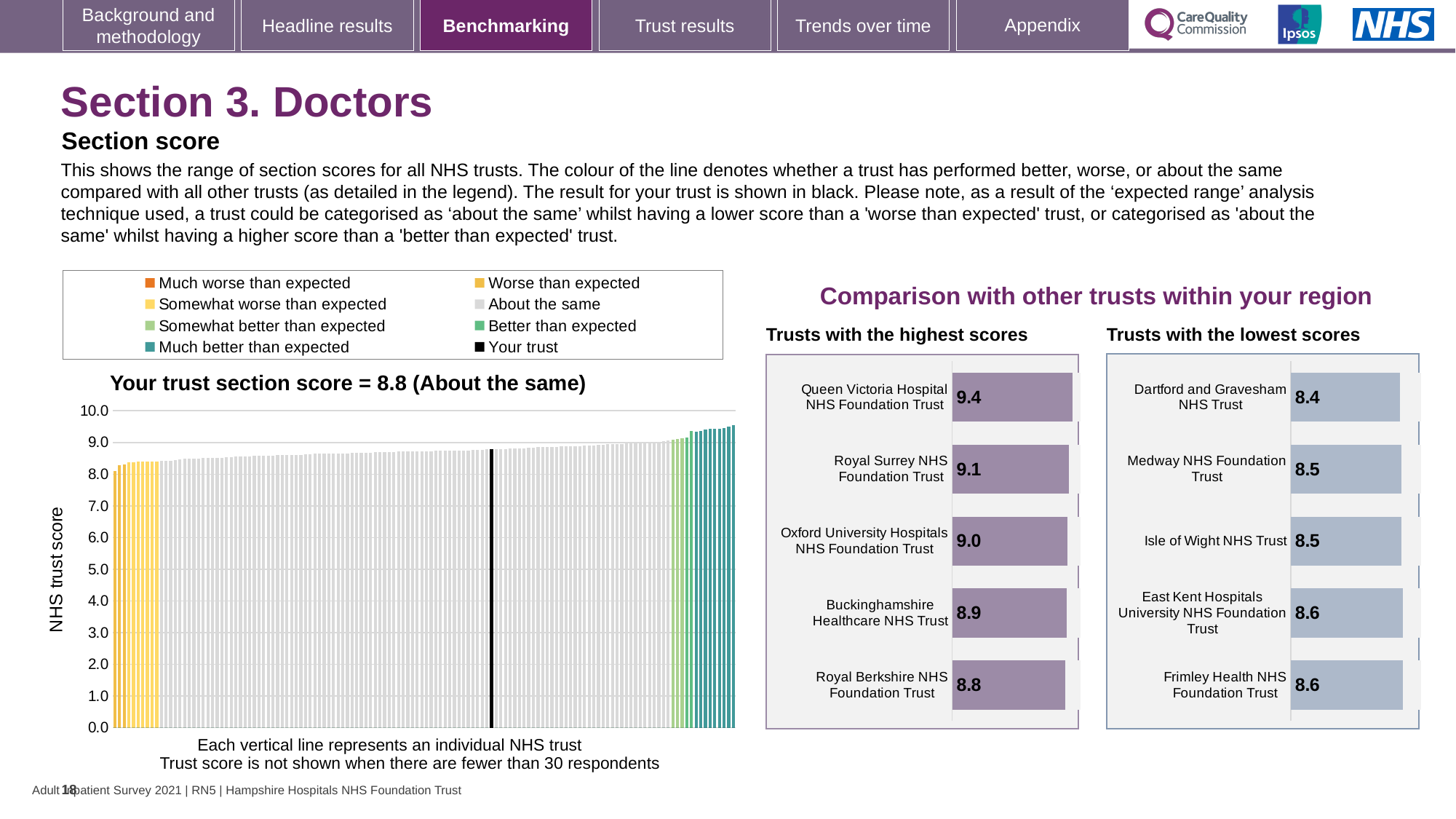
In the 'Trusts with the lowest scores' chart, what is the score for Frimley Health NHS Foundation Trust? 8.6 In the 'Trusts with the highest scores' chart, what is the score for Queen Victoria Hospital NHS Foundation Trust? 9.4 How many entries does the legend above the main 'NHS trust score' chart list? 8 In the 'Trusts with the lowest scores' chart, how many trusts are shown? 5 In the main 'NHS trust score' chart, what is the section score for your trust? 8.8 In the 'Trusts with the highest scores' chart, which trust has the highest score? Queen Victoria Hospital NHS Foundation Trust In the 'Trusts with the highest scores' chart, which has the higher score: Royal Surrey NHS Foundation Trust or Buckinghamshire Healthcare NHS Trust? Royal Surrey NHS Foundation Trust What kind of chart is the main 'NHS trust score' chart on the left? Bar chart In the 'Trusts with the lowest scores' chart, what is the score for Dartford and Gravesham NHS Trust? 8.4 In the 'Trusts with the highest scores' chart, what is the difference between the scores of Queen Victoria Hospital NHS Foundation Trust and Royal Berkshire NHS Foundation Trust? 0.6 In the 'Trusts with the lowest scores' chart, which trust has the lowest score? Dartford and Gravesham NHS Trust In the 'Trusts with the highest scores' chart, what is the score for Oxford University Hospitals NHS Foundation Trust? 9.0